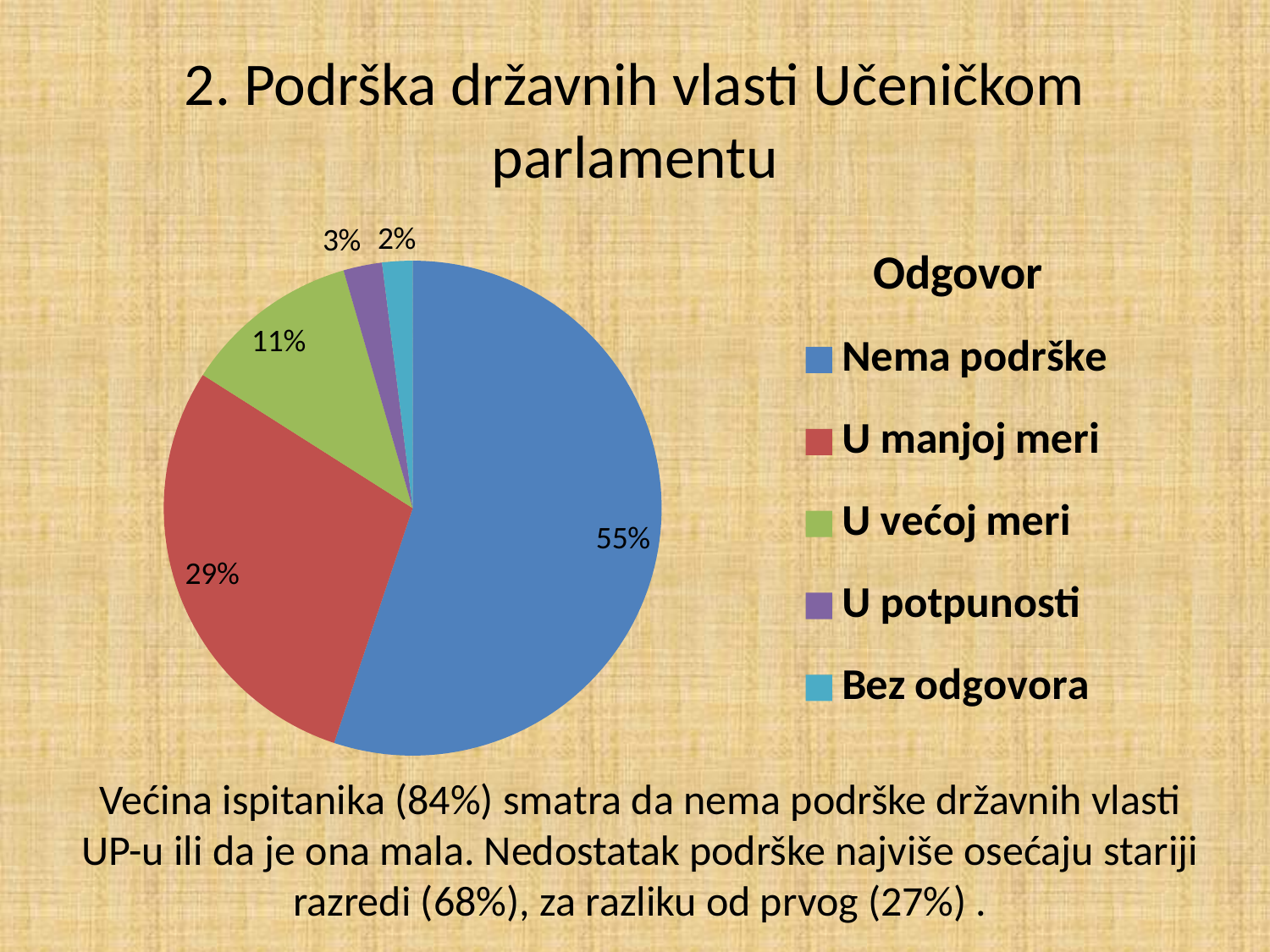
Which category has the smallest slice of the pie? Bez odgovora What share of the pie does "Nema podrške" represent? 55% What kind of chart is shown on the slide? Pie chart What is the difference between the values for "Nema podrške" and "U manjoj meri"? 26% What is the value for "U većoj meri"? 11% How many categories does the pie chart show? 5 Which is larger, "U većoj meri" or "U potpunosti"? U većoj meri What is the value for "U manjoj meri"? 29% What is the value for "Bez odgovora"? 2% What is the value for "U potpunosti"? 3% What is the title of the legend on the chart? Odgovor Which category has the largest slice of the pie? Nema podrške